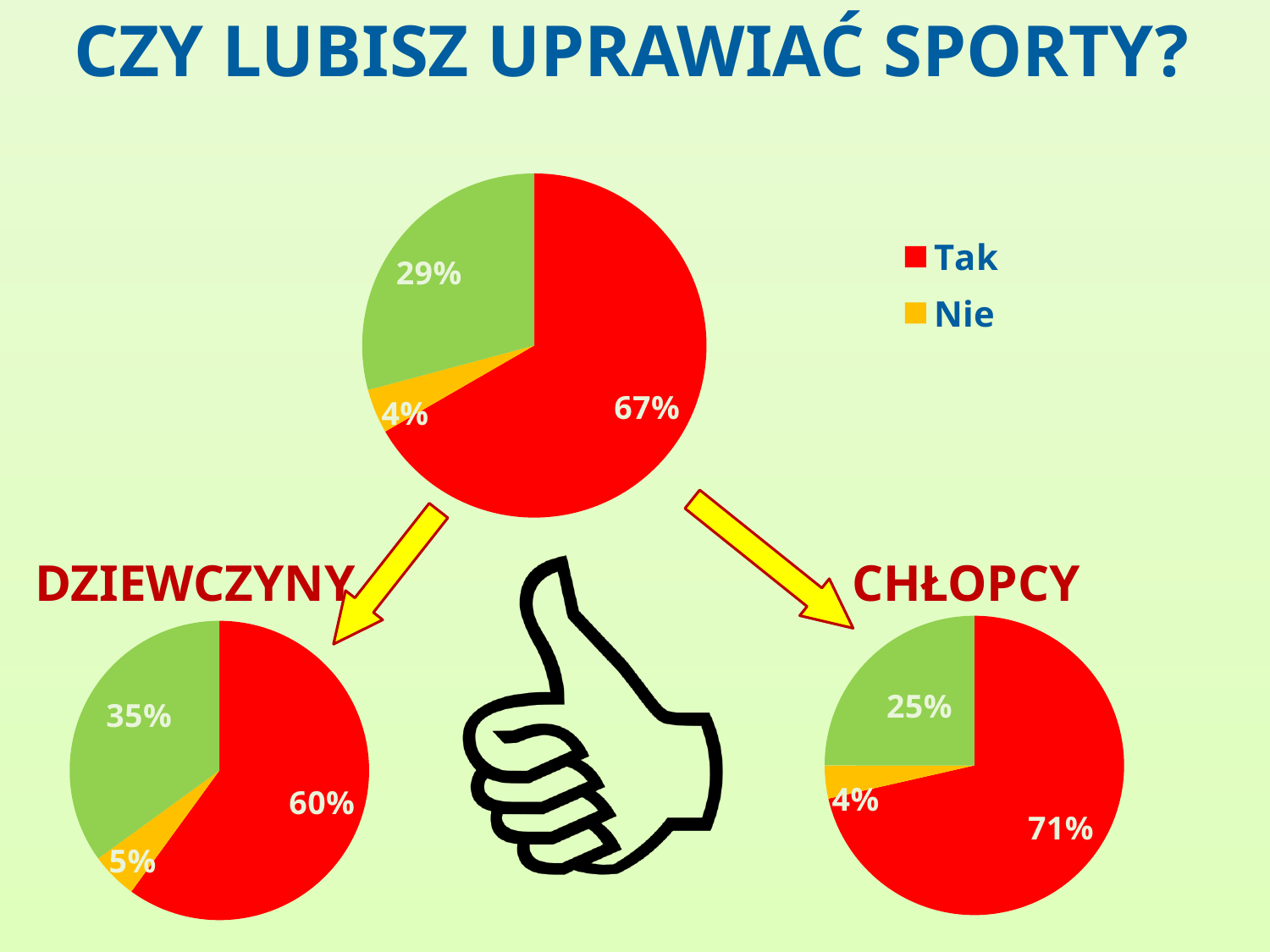
What is the difference between the "Tak" share in the CHŁOPCY pie chart and the "Tak" share in the DZIEWCZYNY pie chart? 11% In the DZIEWCZYNY pie chart, what percentage is shown for "Nie"? 5% In the top pie chart, what percentage is shown for "Tak"? 67% In the DZIEWCZYNY pie chart, which slice is the smallest? Nie In the CHŁOPCY pie chart, which slice is the largest? Tak What type of chart is used on this slide? Pie chart How many entries does the legend list? 2 In the top pie chart, what percentage is shown for "Nie"? 4% In the DZIEWCZYNY pie chart, what percentage is shown for "Tak"? 60% How many slices does the top pie chart have? 3 Is the "Tak" share larger in the DZIEWCZYNY pie chart or the CHŁOPCY pie chart? CHŁOPCY In the CHŁOPCY pie chart, what percentage is shown for "Tak"? 71%